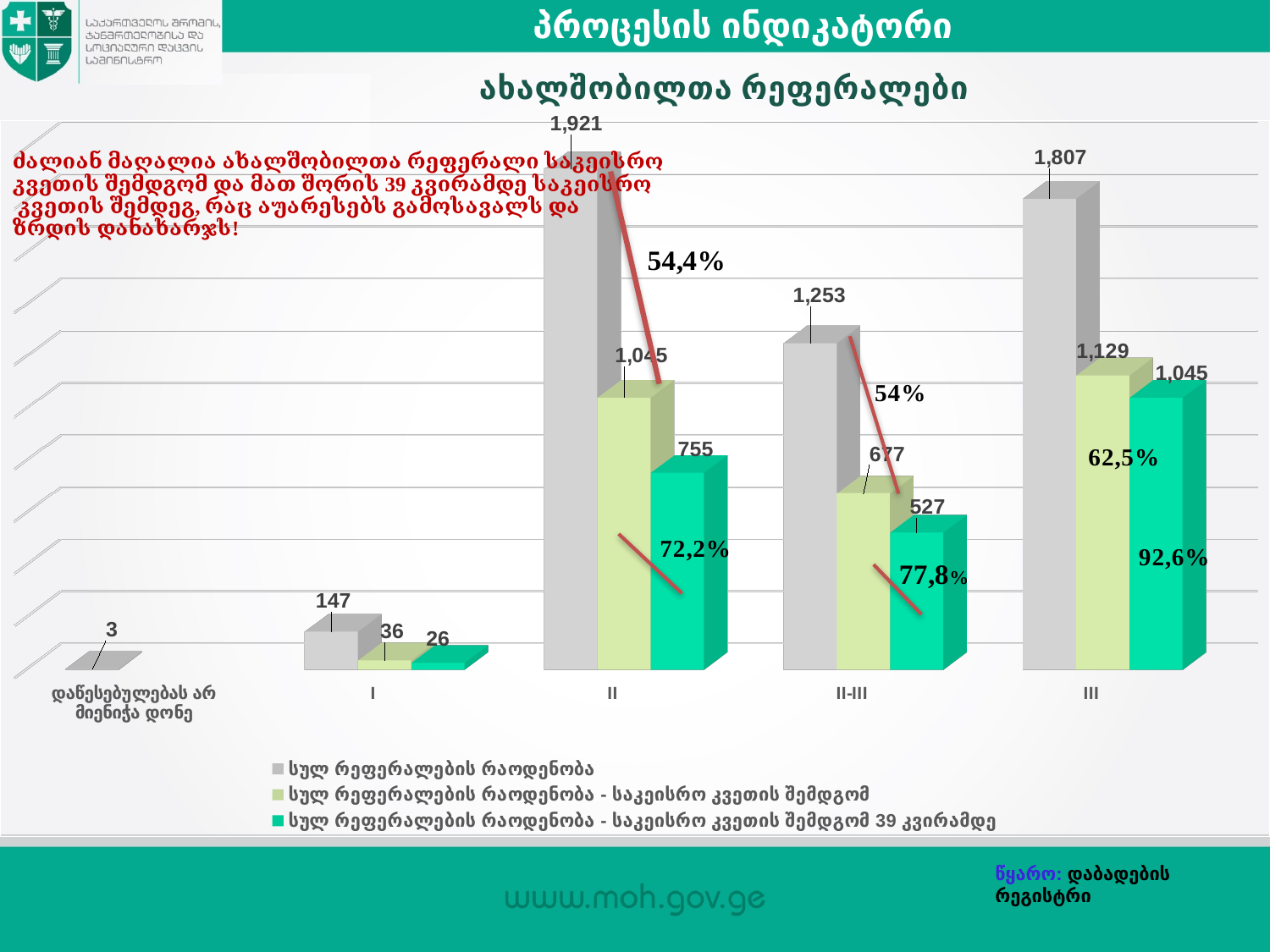
What is the value of the light green series (საკეისრო კვეთის შემდგომ) for category II-III? 677 What percentage is annotated next to the teal bar for category III? 92,6% Which is larger: the light green series value for category II or for category III? category III (1,129) What is the value of the teal series (საკეისრო კვეთის შემდგომ 39 კვირამდე) for category III? 1,045 What is the value of the gray series (სულ რეფერალების რაოდენობა) for category II? 1,921 How many categories are shown on the x axis? 5 Which category has the highest value for the gray series (სულ რეფერალების რაოდენობა)? II What is the value shown for the category დაწესებულებას არ მიენიჭა დონე? 3 How many series does the legend list? 3 What is the difference between the gray series values for categories II and III? 114 Which category has the lowest value for the teal series (საკეისრო კვეთის შემდგომ 39 კვირამდე)? I What type of chart is shown on the slide? bar chart